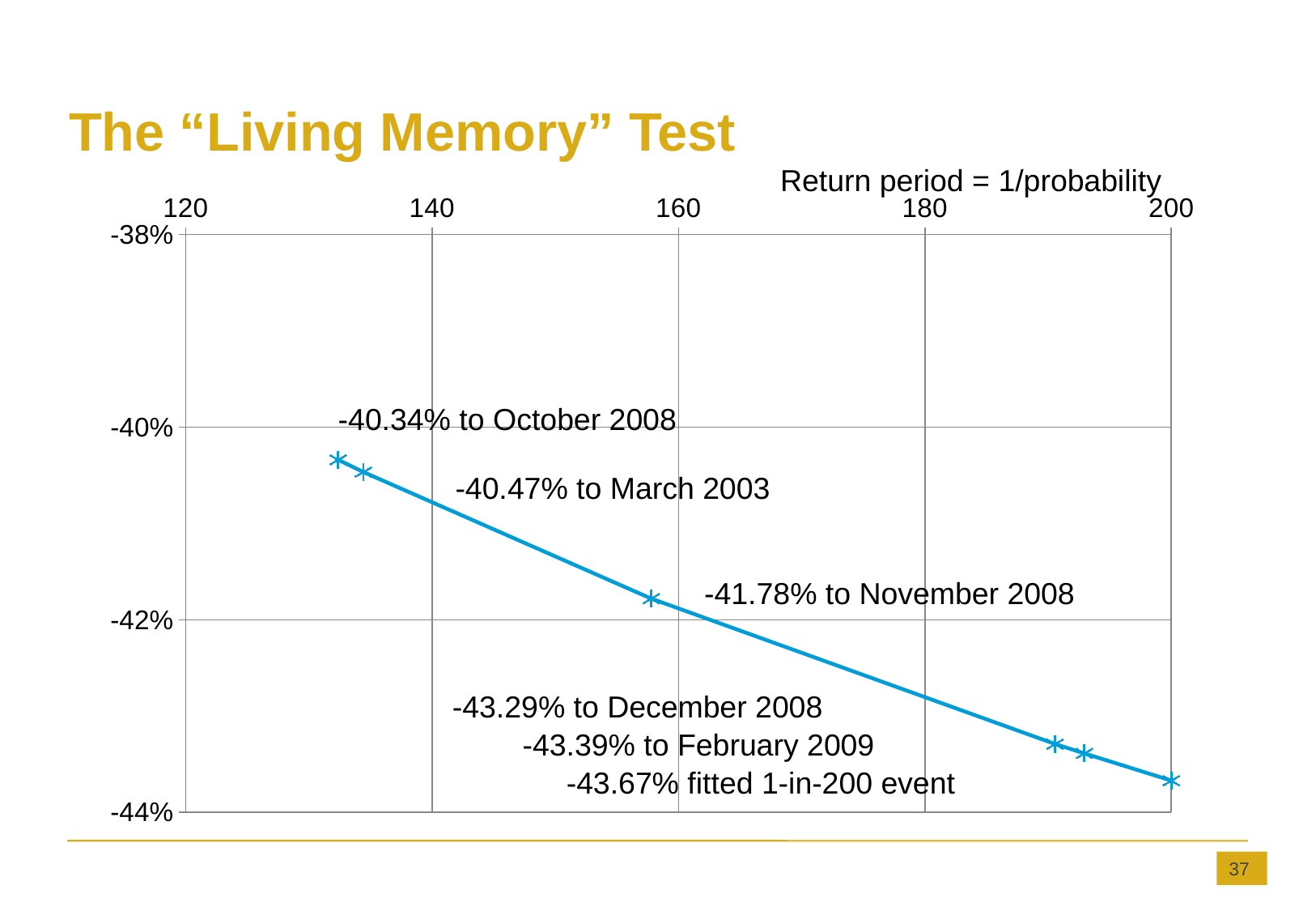
What is the difference between the November 2008 value and the December 2008 value? 1.51 percentage points How many data points are plotted on the line? 6 What is the value labelled for October 2008? -40.34% Do the values rise or fall as the return period increases along the x axis? fall What does the x-axis label say the return period equals? 1/probability Which labelled point has the lowest (most negative) value? fitted 1-in-200 event Which labelled point has the highest (least negative) value? October 2008 Which is more negative, the December 2008 value or the February 2009 value? February 2009 What is the value labelled for the fitted 1-in-200 event? -43.67% What is the value labelled for November 2008? -41.78% What kind of chart is shown on the slide? line chart What is the value labelled for March 2003? -40.47%